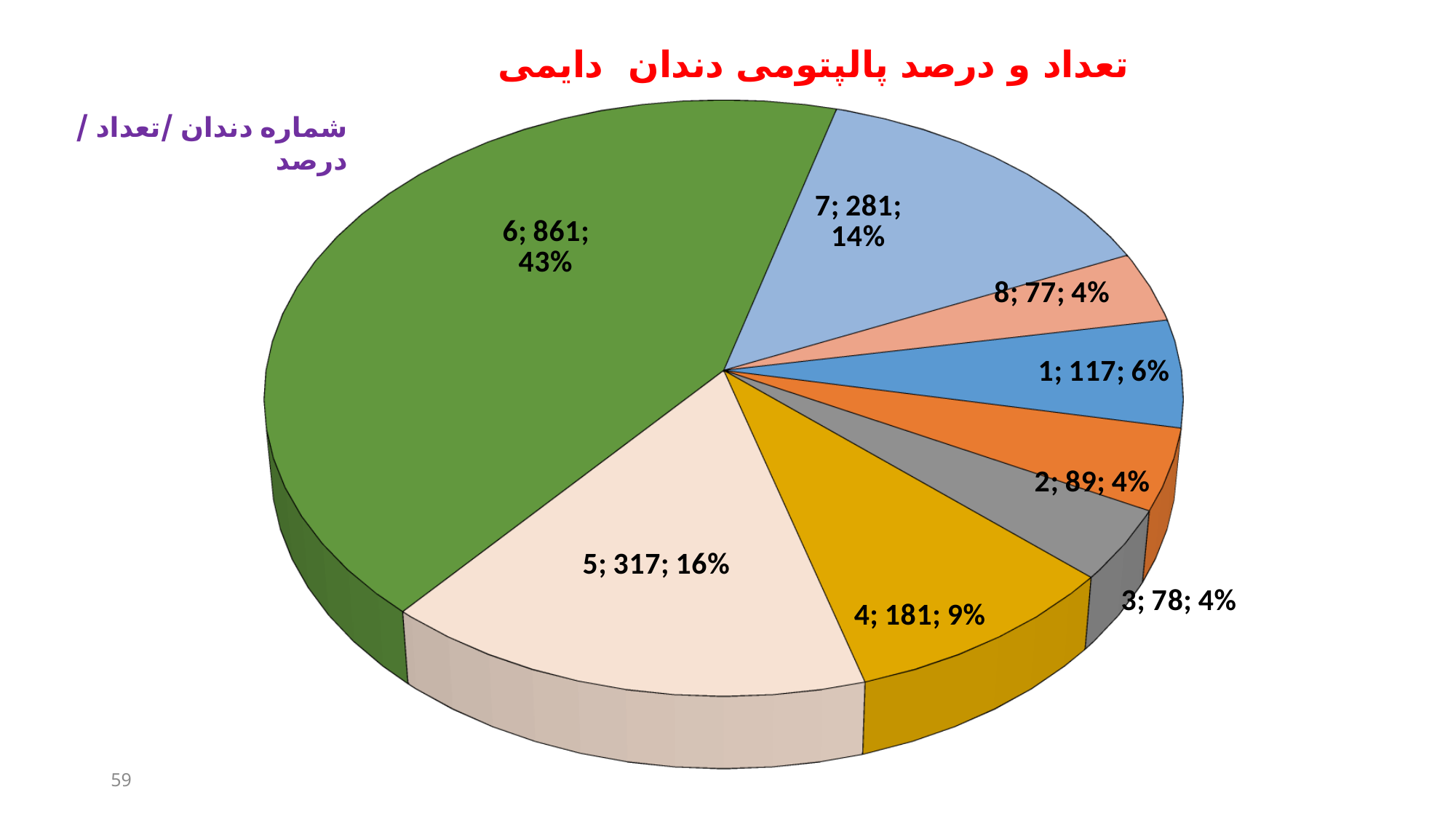
Which tooth number has the smallest count? 8 What kind of chart is shown on the slide? pie chart What percentage is shown for tooth number 7? 14% Which tooth number has the largest slice of the pie? 6 What percentage is shown for tooth number 4? 9% What is the count shown for tooth number 3? 78 What colour is the slice for tooth number 6? green What is the difference between the counts for tooth number 6 and tooth number 5? 544 What is the count shown for tooth number 6? 861 How many slices does the pie chart have? 8 Which has a larger count, tooth number 1 or tooth number 2? tooth number 1 What is the count shown for tooth number 5? 317